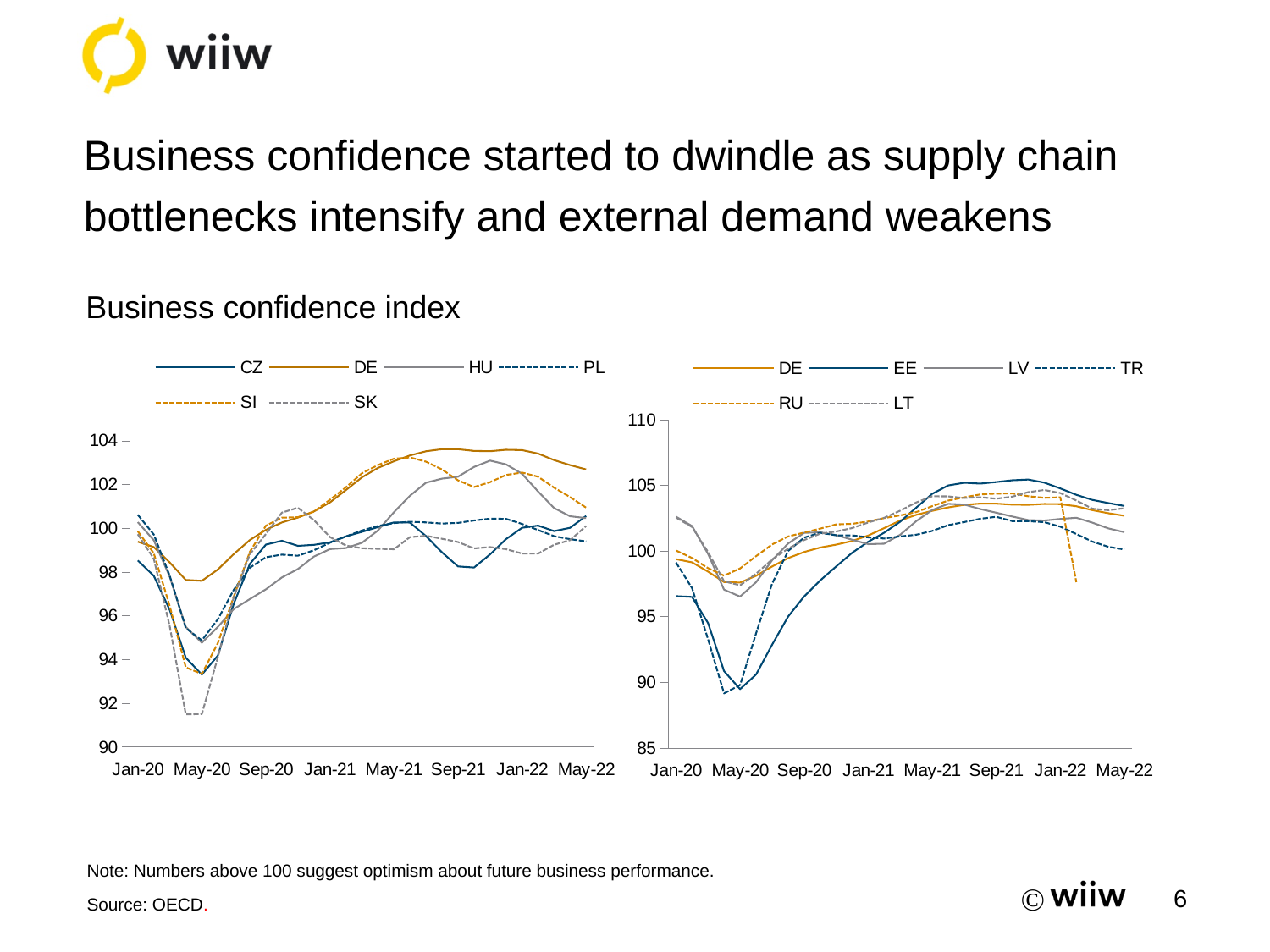
How many series does the legend of the left chart list? 6 In the left chart, is the value for SK in May-20 greater or less than 94? less In the right chart, which is higher in May-20, DE or EE? DE In the left chart, is the value for DE in Sep-21 greater or less than 102? greater In the left chart, which series has the highest value at May-22? DE In the left chart, which series has the lowest value around May-20? SK In the left chart, does the DE line rise or fall between May-20 and Sep-21? rise How many series does the legend of the right chart list? 6 What kind of chart is the left chart on the slide? line chart In the right chart, is the value for DE in Sep-21 greater or less than 100? greater What is the title of the chart area on the slide? Business confidence index